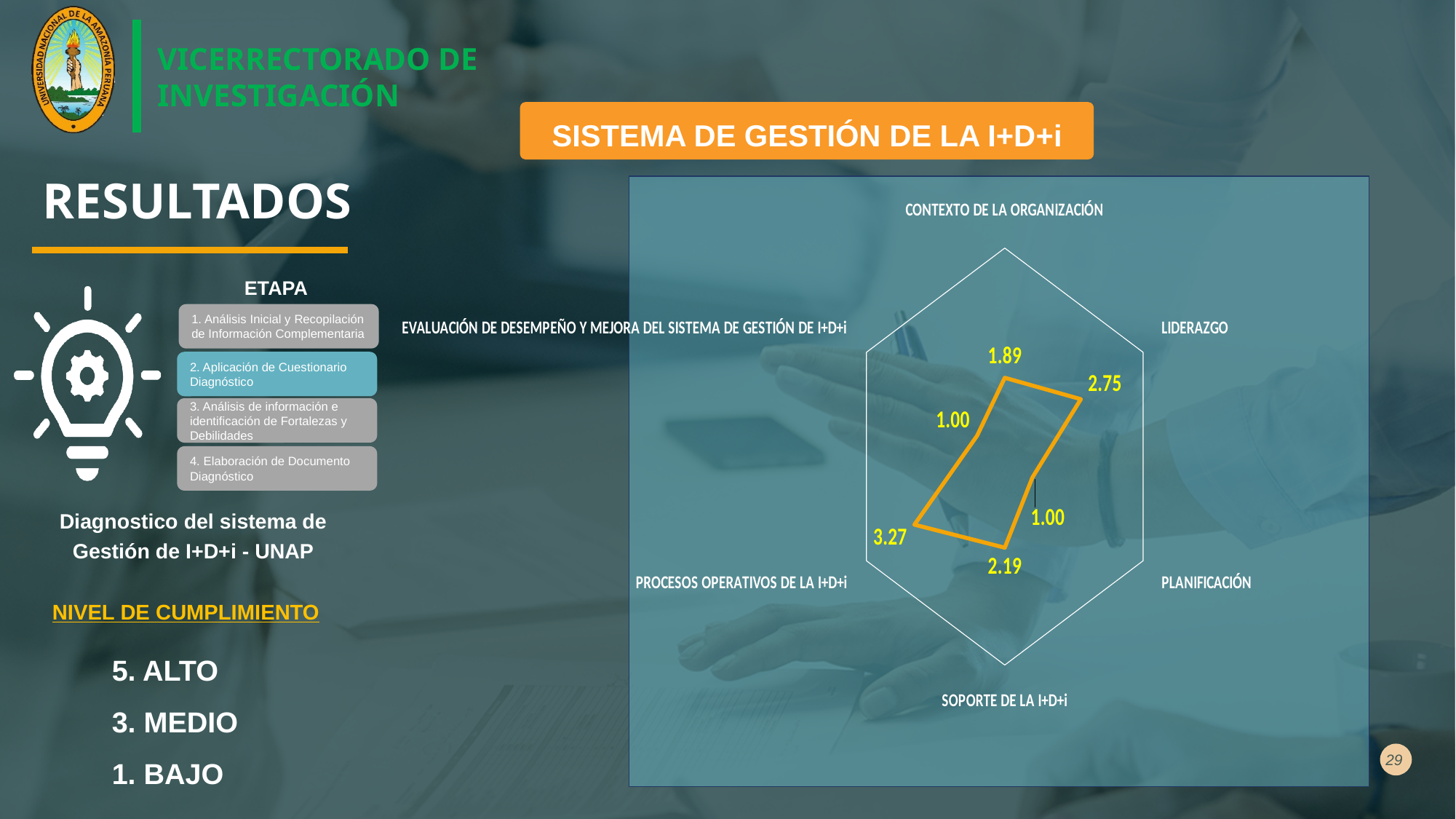
What is the value for SOPORTE DE LA I+D+i? 2.19 What colour is the plotted data line on the radar chart? Orange How many categories (axes) does the radar chart have? 6 What is the value for CONTEXTO DE LA ORGANIZACIÓN? 1.89 What type of chart is shown on the slide? Radar chart What is the difference between the values for PROCESOS OPERATIVOS DE LA I+D+i and LIDERAZGO? 0.52 What is the value for PROCESOS OPERATIVOS DE LA I+D+i? 3.27 What is the difference between the values for LIDERAZGO and CONTEXTO DE LA ORGANIZACIÓN? 0.86 What is the value for LIDERAZGO? 2.75 What is the value for PLANIFICACIÓN? 1.00 Which has a larger value, SOPORTE DE LA I+D+i or CONTEXTO DE LA ORGANIZACIÓN? SOPORTE DE LA I+D+i Which category has the highest value? PROCESOS OPERATIVOS DE LA I+D+i